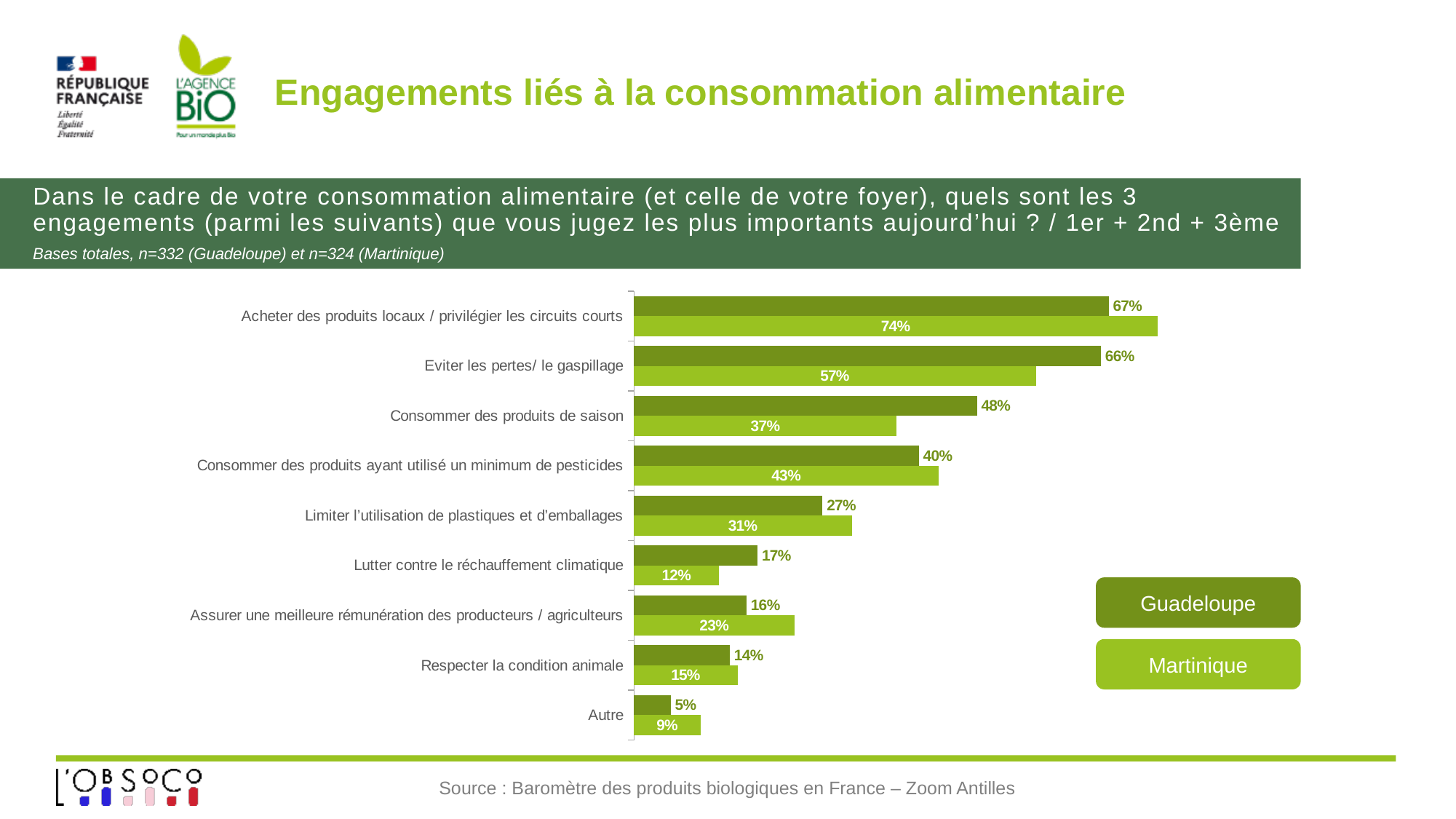
What is the value for Guadeloupe for "Acheter des produits locaux / privilégier les circuits courts"? 67% Which category has the lowest value for Guadeloupe? Autre How many series does the legend list? 2 Which series is shown in the darker green colour? Guadeloupe What is the difference between the Martinique and Guadeloupe values for "Assurer une meilleure rémunération des producteurs / agriculteurs"? 7% For "Consommer des produits ayant utilisé un minimum de pesticides", which is larger: the Guadeloupe value or the Martinique value? Martinique Which category has the highest value for Martinique? Acheter des produits locaux / privilégier les circuits courts How many categories are shown on the chart? 9 What is the value for Martinique for "Eviter les pertes/ le gaspillage"? 57% What kind of chart is shown on the slide? Bar chart For "Lutter contre le réchauffement climatique", which is larger: the Guadeloupe value or the Martinique value? Guadeloupe What is the value for Martinique for "Consommer des produits de saison"? 37%